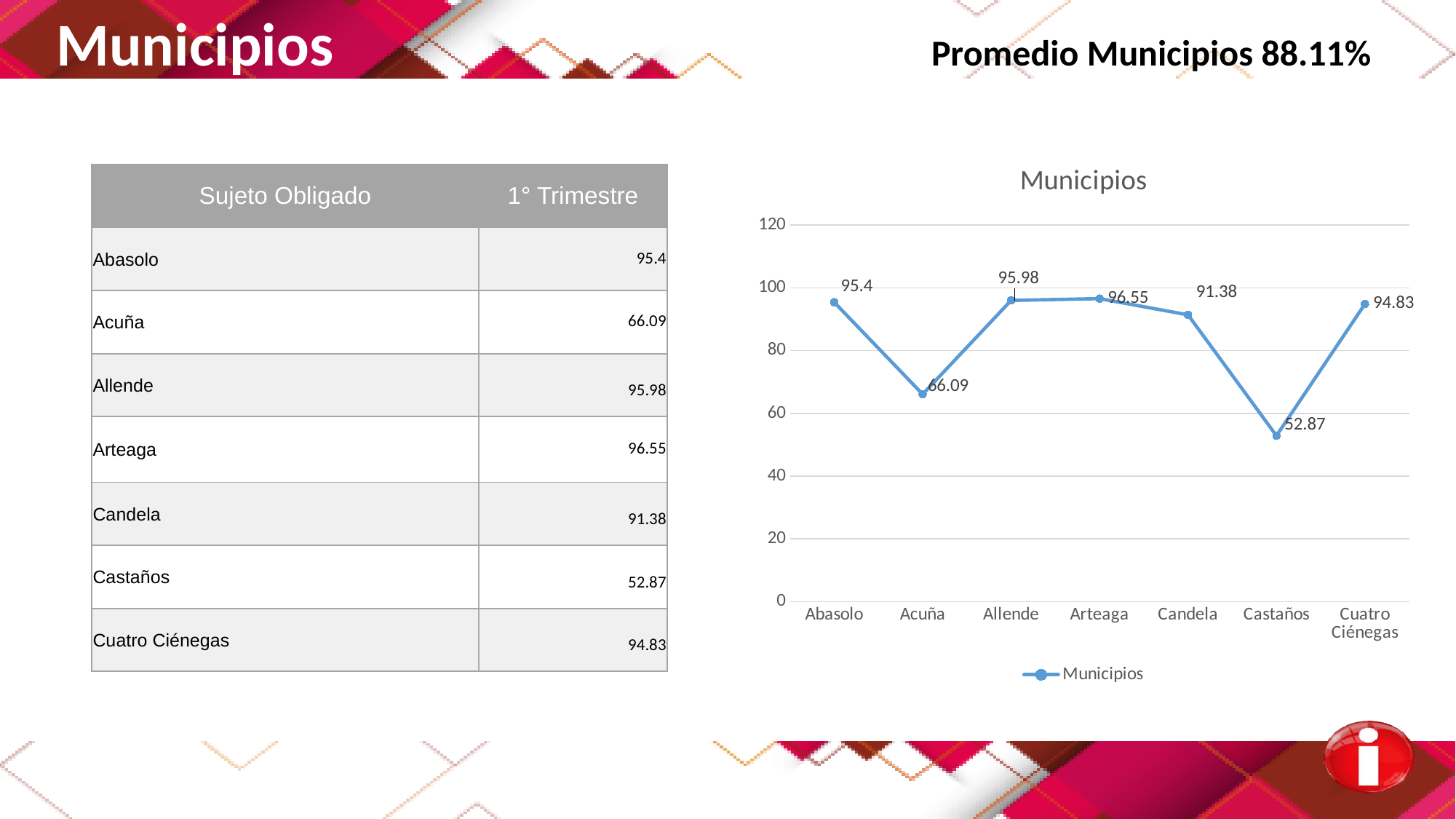
What is the difference between the values for Arteaga and Castaños in the Municipios chart? 43.68 What is the value for Cuatro Ciénegas in the Municipios chart? 94.83 What is the value for Castaños in the Municipios chart? 52.87 What is the difference between the values for Abasolo and Acuña in the Municipios chart? 29.31 Which municipality has the lowest value in the Municipios chart? Castaños What is the value for Abasolo in the Municipios chart? 95.4 Is the value for Acuña in the Municipios chart greater or less than 80? less Which municipality has the highest value in the Municipios chart? Arteaga How many series does the legend of the Municipios chart list? 1 How many municipalities are plotted in the Municipios chart? 7 Which is larger in the Municipios chart, the value for Candela or the value for Acuña? Candela What kind of chart is the Municipios chart? line chart